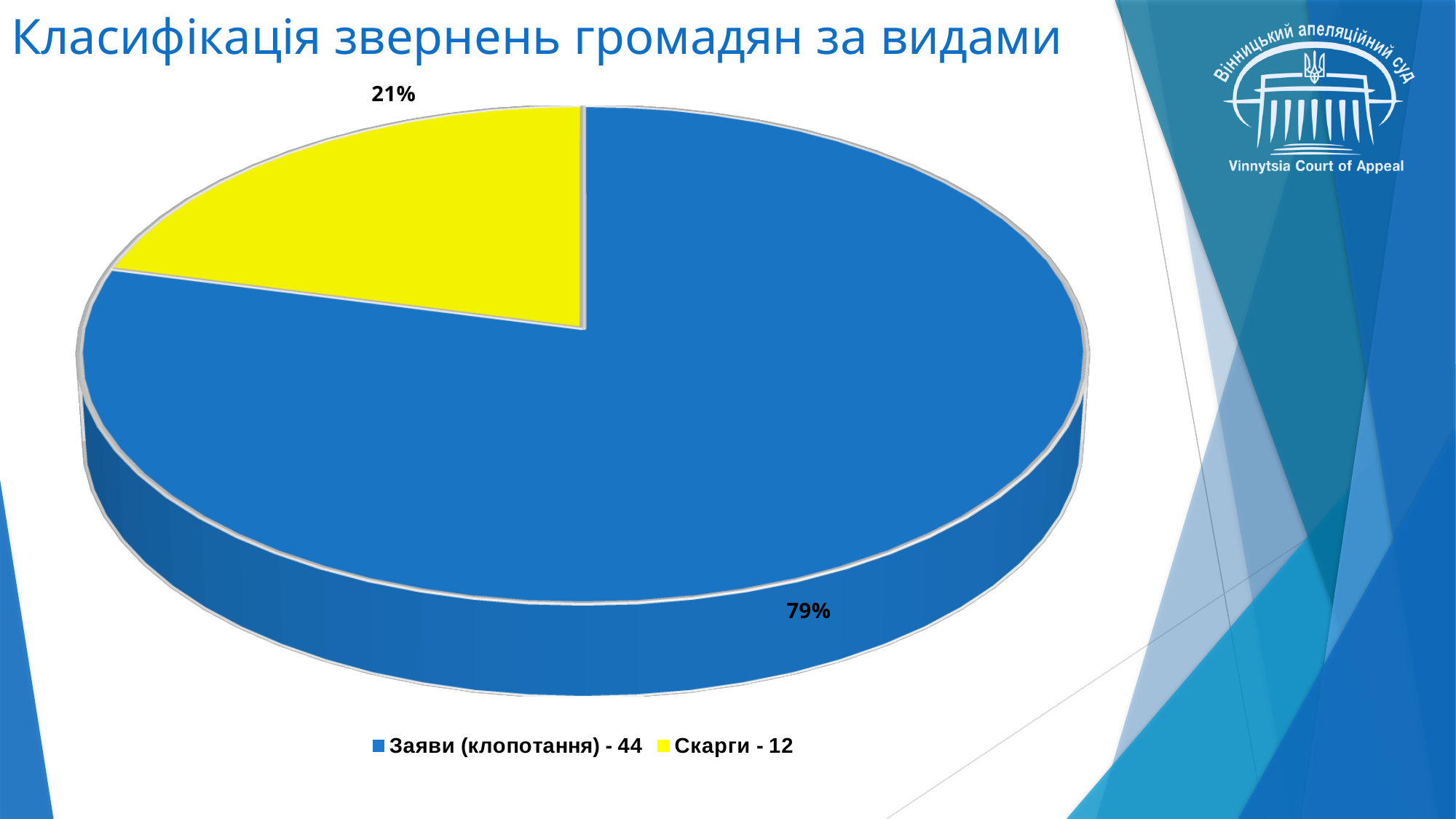
How many slices does the pie chart have? 2 Which slice is the smallest in the pie chart? Скарги - 12 What is the title of the chart on the slide? Класифікація звернень громадян за видами What is the difference in percentage points between the "Заяви (клопотання)" slice and the "Скарги" slice? 58 How many entries does the legend list? 2 What kind of chart is shown on the slide? pie chart What colour is the "Скарги - 12" slice? yellow Which is larger: the share for "Заяви (клопотання)" or the share for "Скарги"? Заяви (клопотання) What is the total of the counts given in the legend entries (44 and 12)? 56 What percentage share does the slice "Скарги - 12" have? 21% Which slice is the largest in the pie chart? Заяви (клопотання) - 44 What percentage share does the slice "Заяви (клопотання) - 44" have? 79%